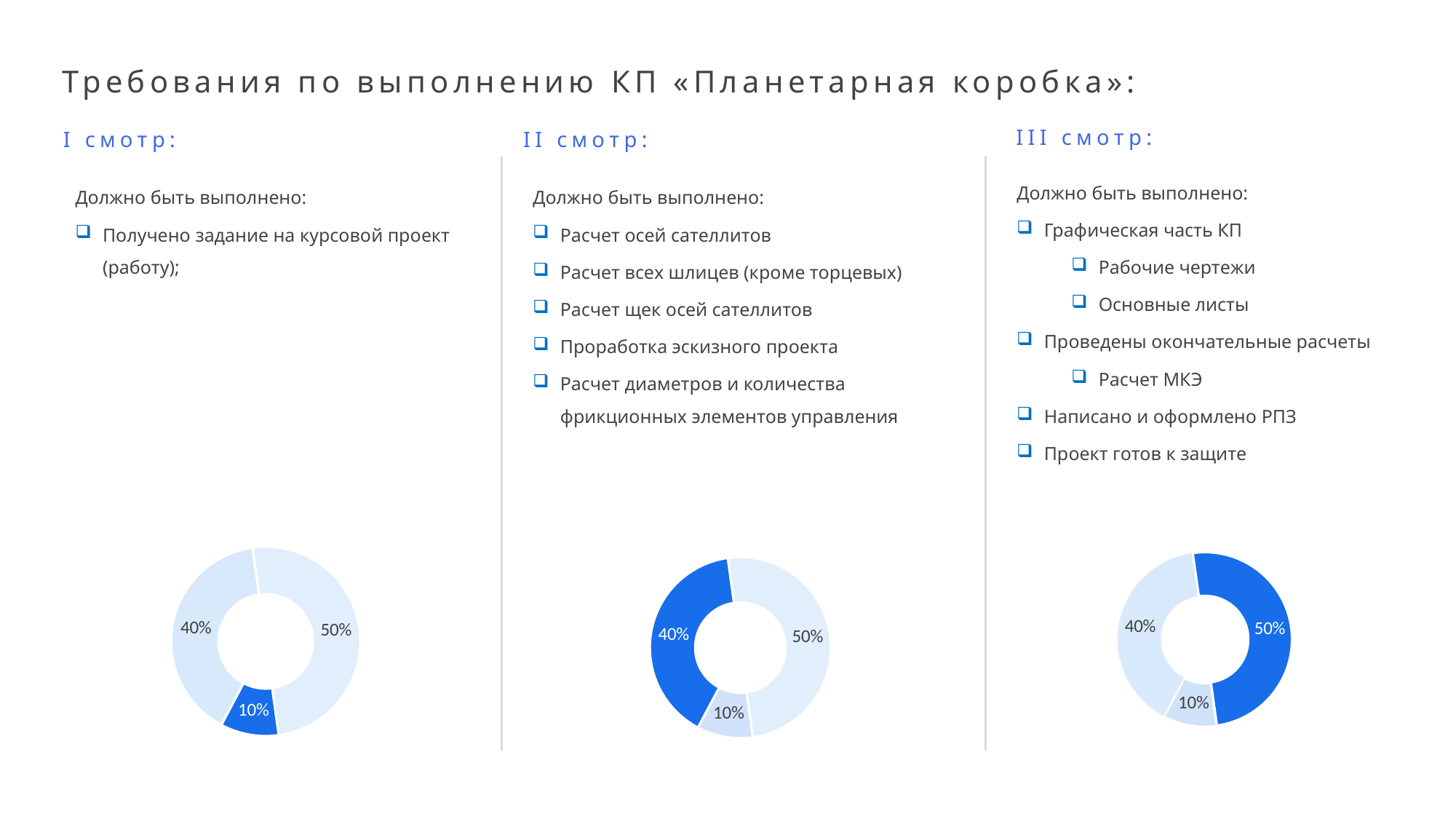
In the doughnut chart in the left column, what is the value of the smallest slice? 10% In the doughnut chart in the middle column, what is the difference between the largest and smallest slices? 40% How many slices does the doughnut chart in the left column have? 3 How many doughnut charts are shown on the slide? 3 In the doughnut chart in the left column, which slice is highlighted in dark blue? 10% In the doughnut chart in the right column, what is the combined share of the 40% and 10% slices? 50% In the doughnut chart in the left column, what is the value of the largest slice? 50% In the doughnut chart in the middle column (under "II смотр"), which slice is highlighted in dark blue? 40% In the doughnut chart in the middle column, is the 40% slice larger or smaller than the 50% slice? smaller In the doughnut chart in the right column (under "III смотр"), what is the value of the dark blue highlighted slice? 50% What kind of chart is shown at the bottom of the left column (under "I смотр")? Doughnut (pie) chart In the doughnut chart in the right column, what is the value of the smallest slice? 10%